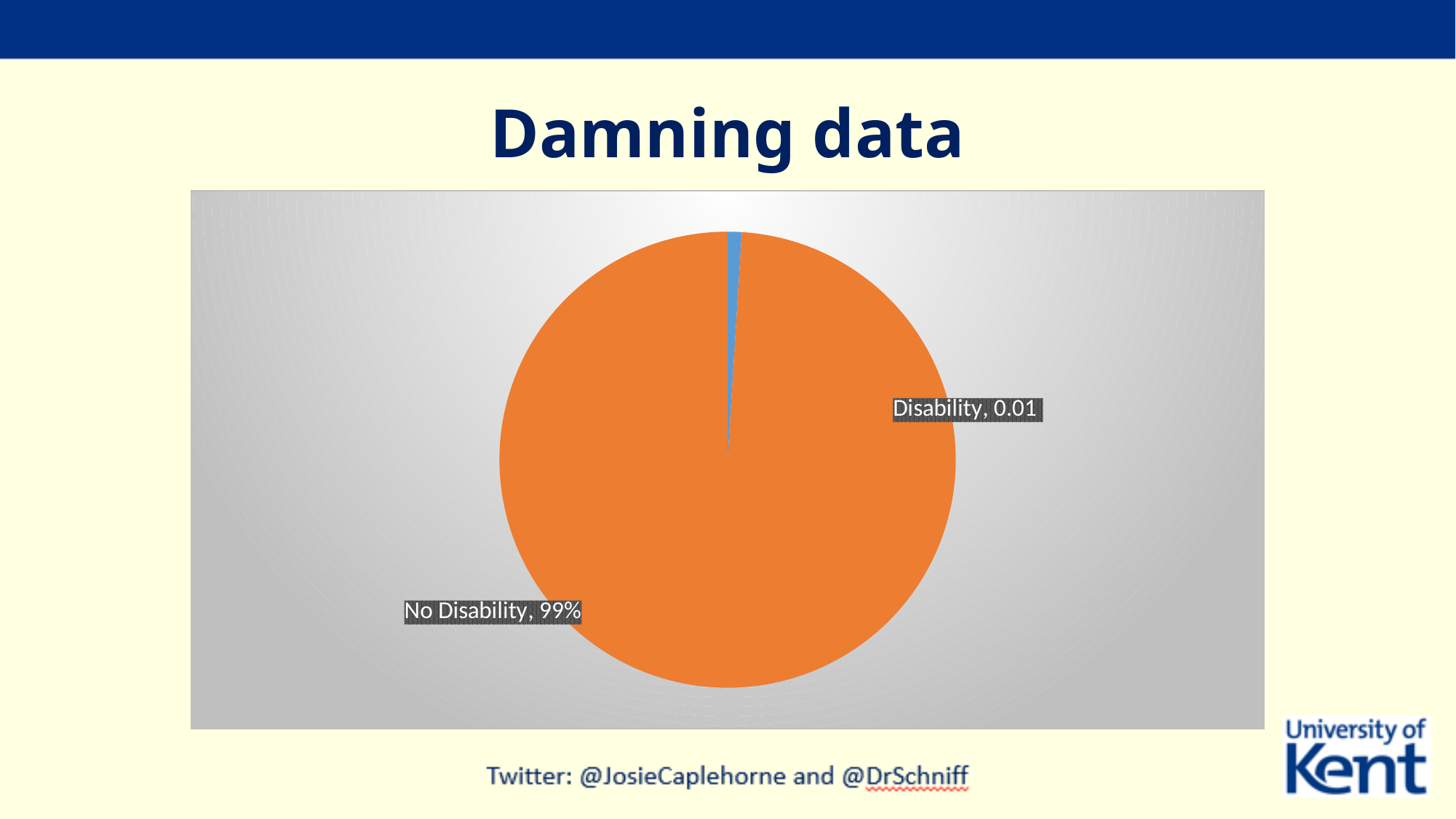
What colour is the Disability slice? blue What kind of chart is shown on the slide? pie chart What colour is the No Disability slice? orange Which slice of the pie chart is the largest? No Disability How many slices does the pie chart have? 2 What share of the pie does the No Disability slice take up? 99% Which slice of the pie chart is the smallest? Disability Which is larger, the No Disability slice or the Disability slice? No Disability What value is labelled for the Disability slice? 0.01 What value is labelled for the No Disability slice? 99%